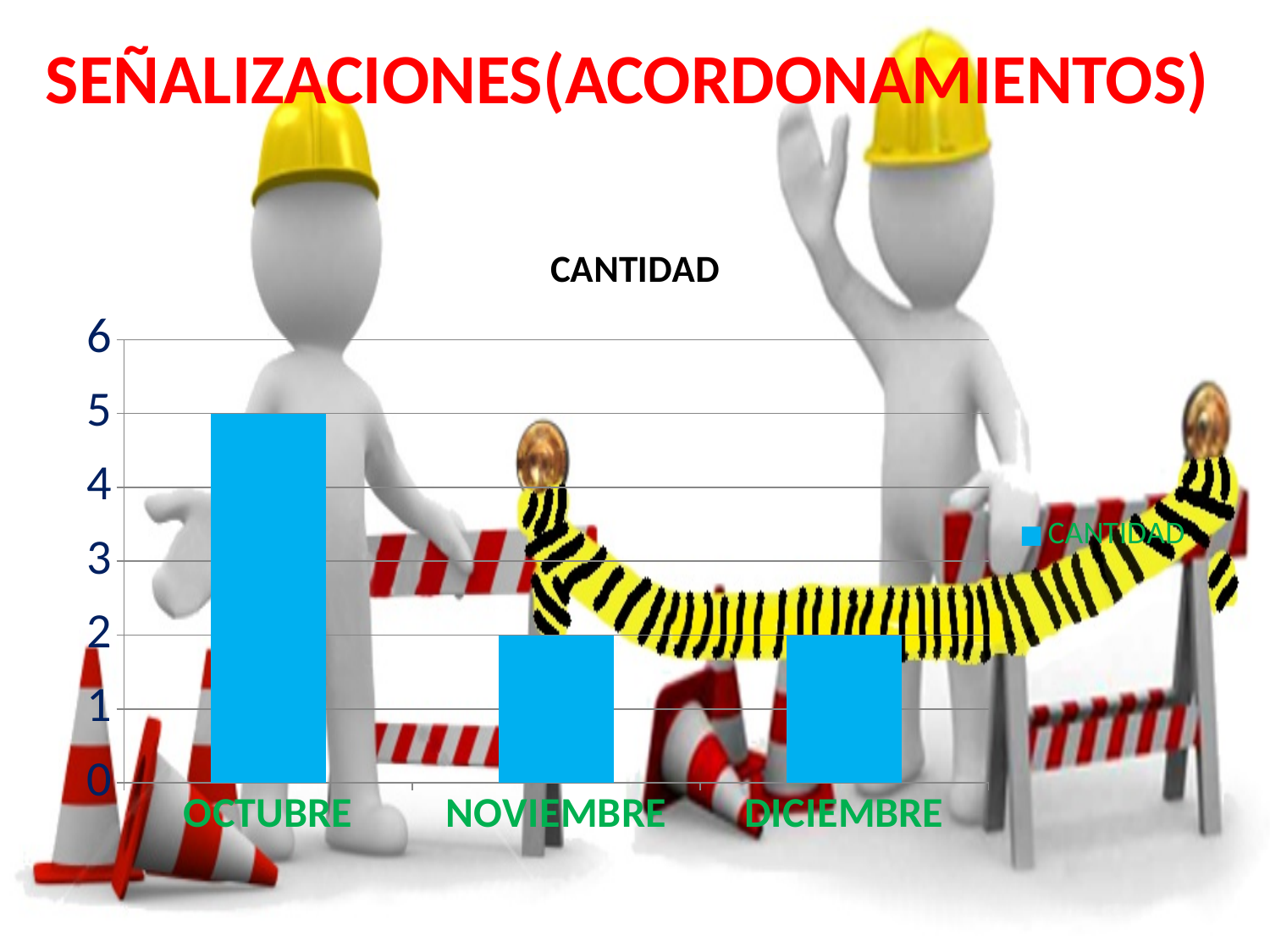
Do the values rise or fall from OCTUBRE to NOVIEMBRE? fall What is the value for OCTUBRE? 5 What is the value for DICIEMBRE? 2 Which month has the highest value? OCTUBRE Which is larger, the value for OCTUBRE or the value for DICIEMBRE? OCTUBRE What type of chart is shown on the slide? Bar chart How many categories are shown on the x axis of the chart? 3 What is the title of the chart? CANTIDAD What is the difference between the values for OCTUBRE and NOVIEMBRE? 3 How many series does the chart legend list? 1 Is the value for OCTUBRE greater or less than 4? greater What is the value for NOVIEMBRE? 2